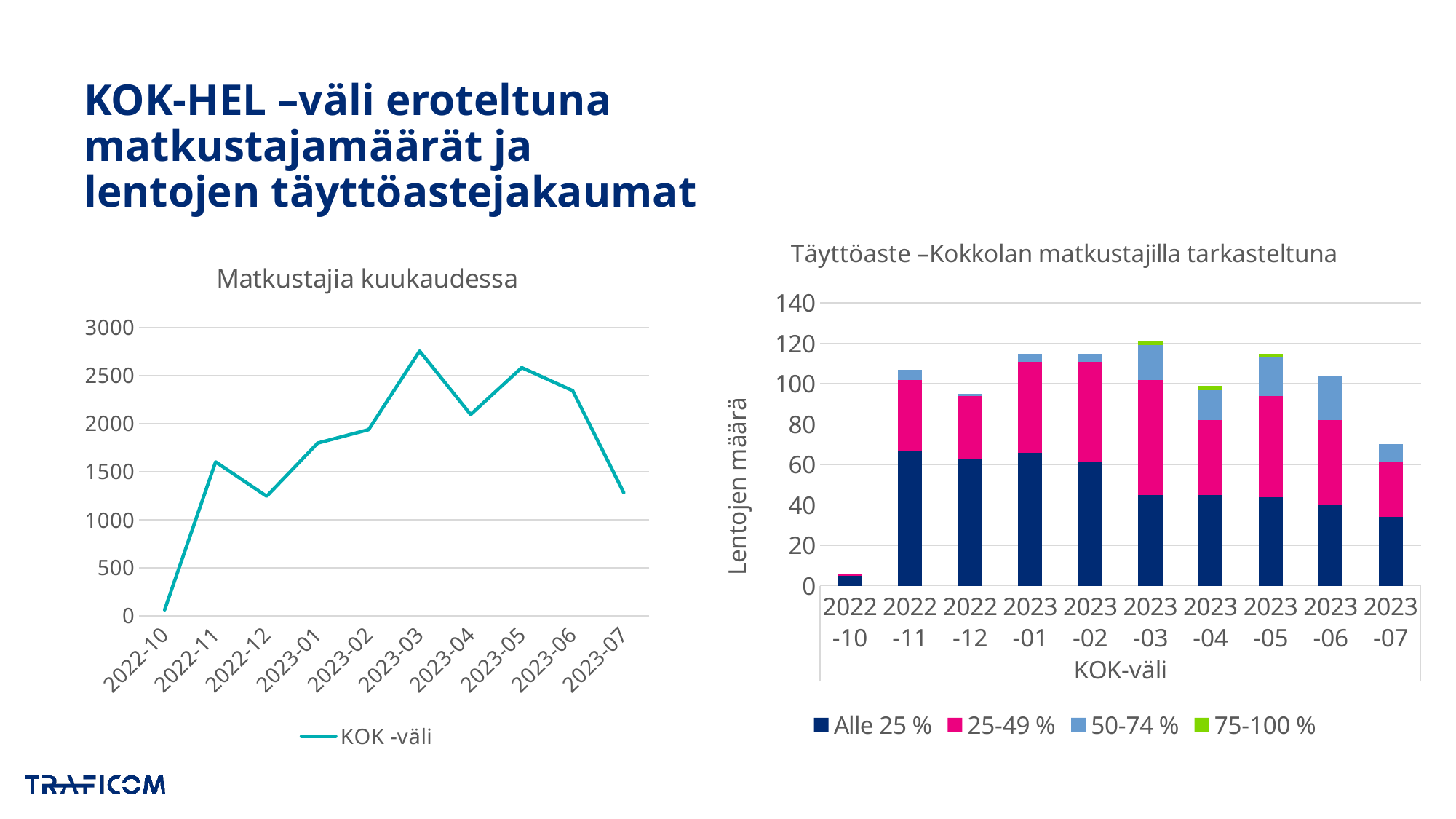
In the chart "Täyttöaste –Kokkolan matkustajilla tarkasteltuna", which month has the shortest stacked bar? 2022-10 In the chart "Matkustajia kuukaudessa", which month has the lowest number of passengers? 2022-10 What kind of chart is the chart titled "Matkustajia kuukaudessa"? line chart In the chart "Täyttöaste –Kokkolan matkustajilla tarkasteltuna", which month has the tallest stacked bar? 2023-03 In the chart "Matkustajia kuukaudessa", is the value for 2023-03 greater or less than 2500? greater In the chart "Matkustajia kuukaudessa", how many months are plotted on the x axis? 10 In the chart "Matkustajia kuukaudessa", is the value for 2023-07 greater or less than 1500? less In the chart "Täyttöaste –Kokkolan matkustajilla tarkasteltuna", is the total for 2023-07 greater or less than 80? less What kind of chart is the chart titled "Täyttöaste –Kokkolan matkustajilla tarkasteltuna"? stacked bar chart In the chart "Matkustajia kuukaudessa", do the values rise or fall from 2023-05 to 2023-07? fall In the chart "Täyttöaste –Kokkolan matkustajilla tarkasteltuna", how many series does the legend list? 4 In the chart "Matkustajia kuukaudessa", which month has the highest number of passengers? 2023-03